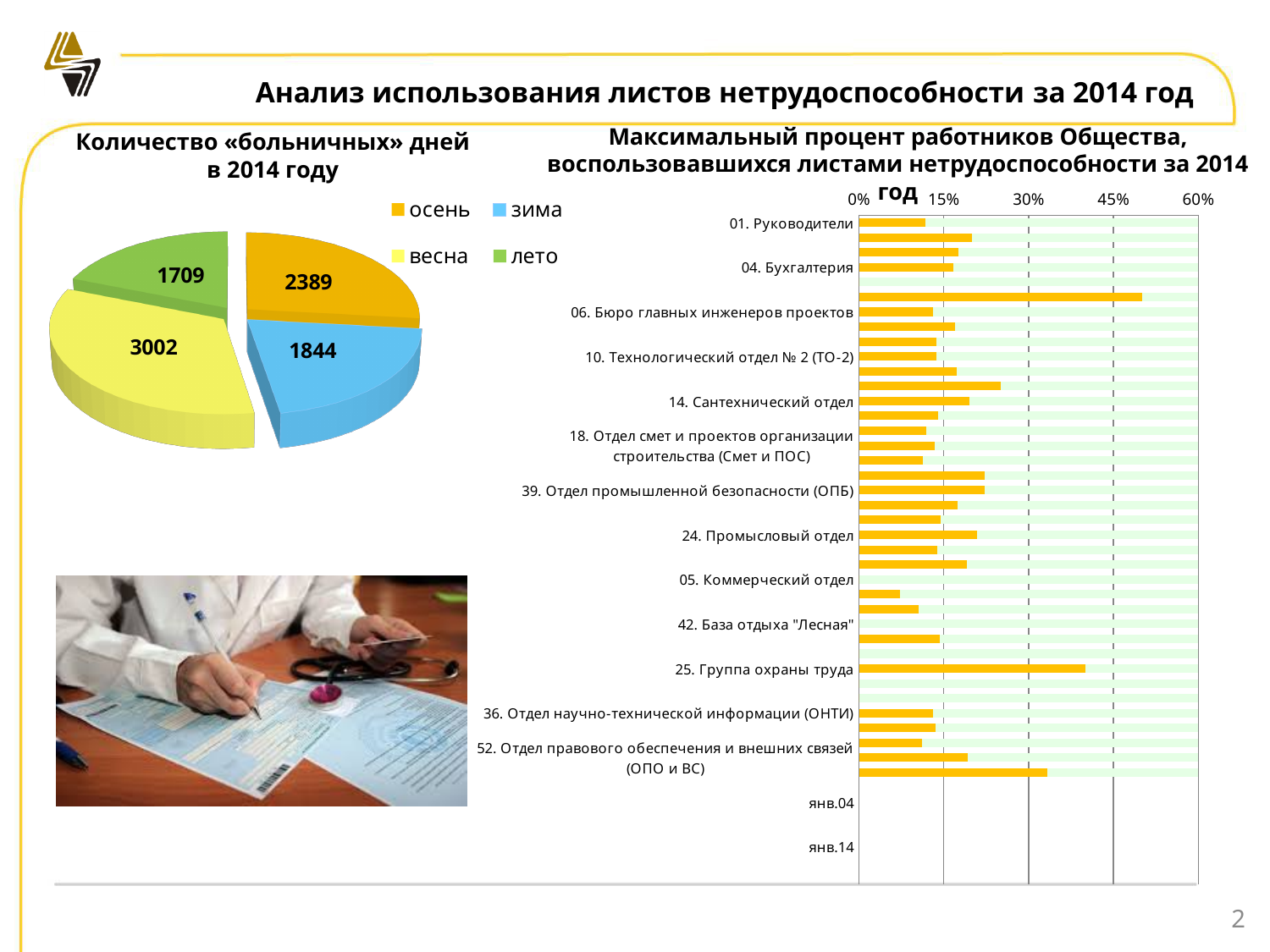
In the pie chart 'Количество «больничных» дней в 2014 году', how many sick days are shown for зима? 1844 What type of chart is the chart on the right titled 'Максимальный процент работников Общества, воспользовавшихся листами нетрудоспособности за 2014 год'? bar chart In the pie chart 'Количество «больничных» дней в 2014 году', how many sick days are shown for весна? 3002 In the pie chart 'Количество «больничных» дней в 2014 году', what is the total number of sick days across all four seasons? 8944 In the bar chart on the right, is the value for '25. Группа охраны труда' greater or less than 30%? greater In the pie chart 'Количество «больничных» дней в 2014 году', which season has the highest number of sick days? весна How many slices does the pie chart 'Количество «больничных» дней в 2014 году' have? 4 In the pie chart 'Количество «больничных» дней в 2014 году', which has more sick days, осень or зима? осень In the pie chart 'Количество «больничных» дней в 2014 году', what is the difference between the sick days for весна and осень? 613 What type of chart is the chart on the left titled 'Количество «больничных» дней в 2014 году'? pie chart In the bar chart on the right, is the value for '42. База отдыха "Лесная"' greater or less than 15%? less In the pie chart 'Количество «больничных» дней в 2014 году', which season has the lowest number of sick days? лето